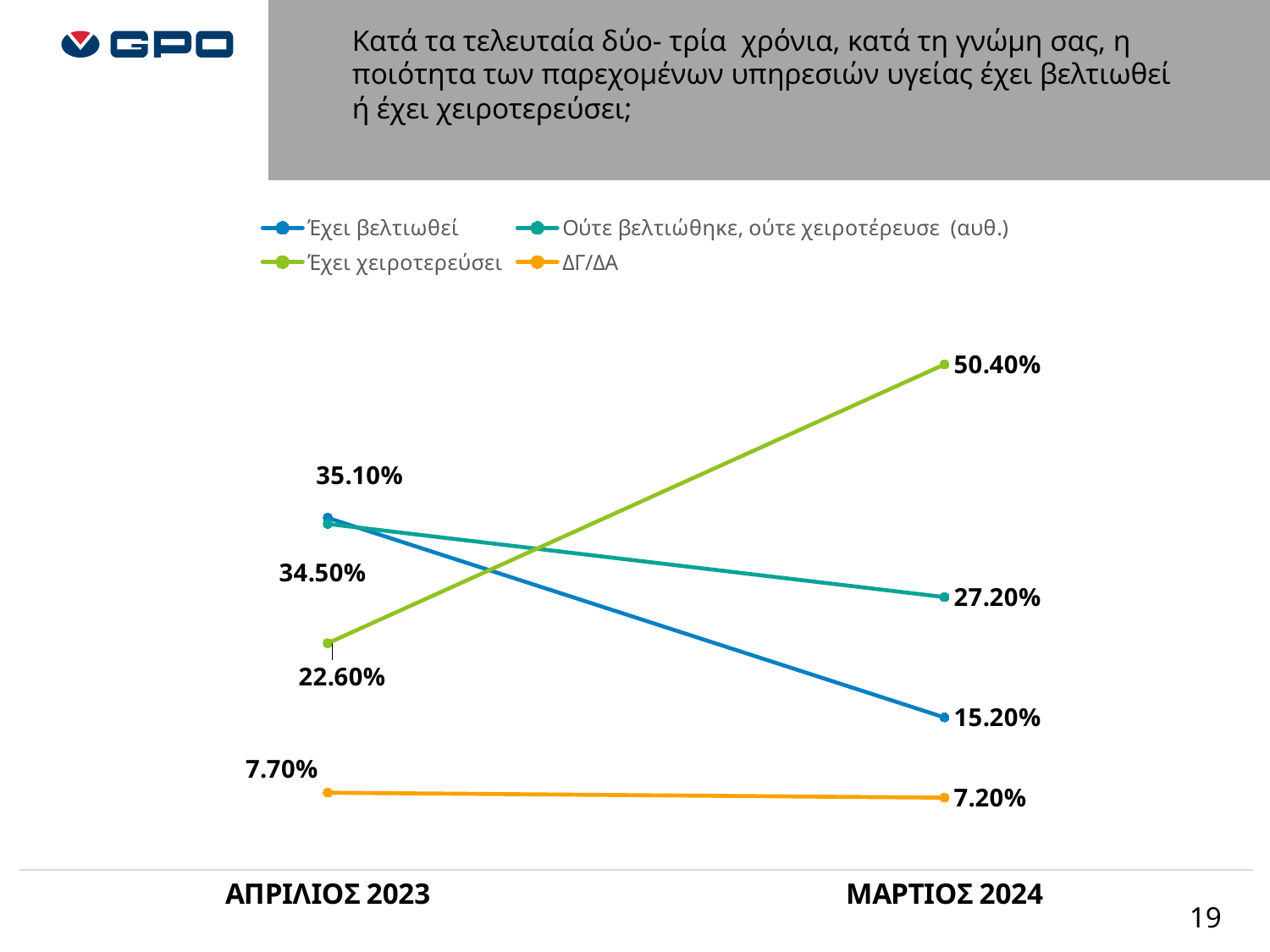
What is the value for Έχει βελτιωθεί in ΑΠΡΙΛΙΟΣ 2023? 35.10% By how much did the value for Έχει χειροτερεύσει change from ΑΠΡΙΛΙΟΣ 2023 to ΜΑΡΤΙΟΣ 2024? 27.80% What type of chart is shown on the slide? line chart How many time points are shown on the x axis? 2 Which series has the lowest value in ΑΠΡΙΛΙΟΣ 2023? ΔΓ/ΔΑ Does the value for Έχει βελτιωθεί rise or fall from ΑΠΡΙΛΙΟΣ 2023 to ΜΑΡΤΙΟΣ 2024? fall Which is larger in ΜΑΡΤΙΟΣ 2024: Έχει βελτιωθεί or Ούτε βελτιώθηκε, ούτε χειροτέρευσε (αυθ.)? Ούτε βελτιώθηκε, ούτε χειροτέρευσε (αυθ.) How many series does the legend list? 4 What is the value for Έχει χειροτερεύσει in ΜΑΡΤΙΟΣ 2024? 50.40% What is the value for ΔΓ/ΔΑ in ΜΑΡΤΙΟΣ 2024? 7.20% Which series has the highest value in ΜΑΡΤΙΟΣ 2024? Έχει χειροτερεύσει What is the value for Ούτε βελτιώθηκε, ούτε χειροτέρευσε (αυθ.) in ΜΑΡΤΙΟΣ 2024? 27.20%